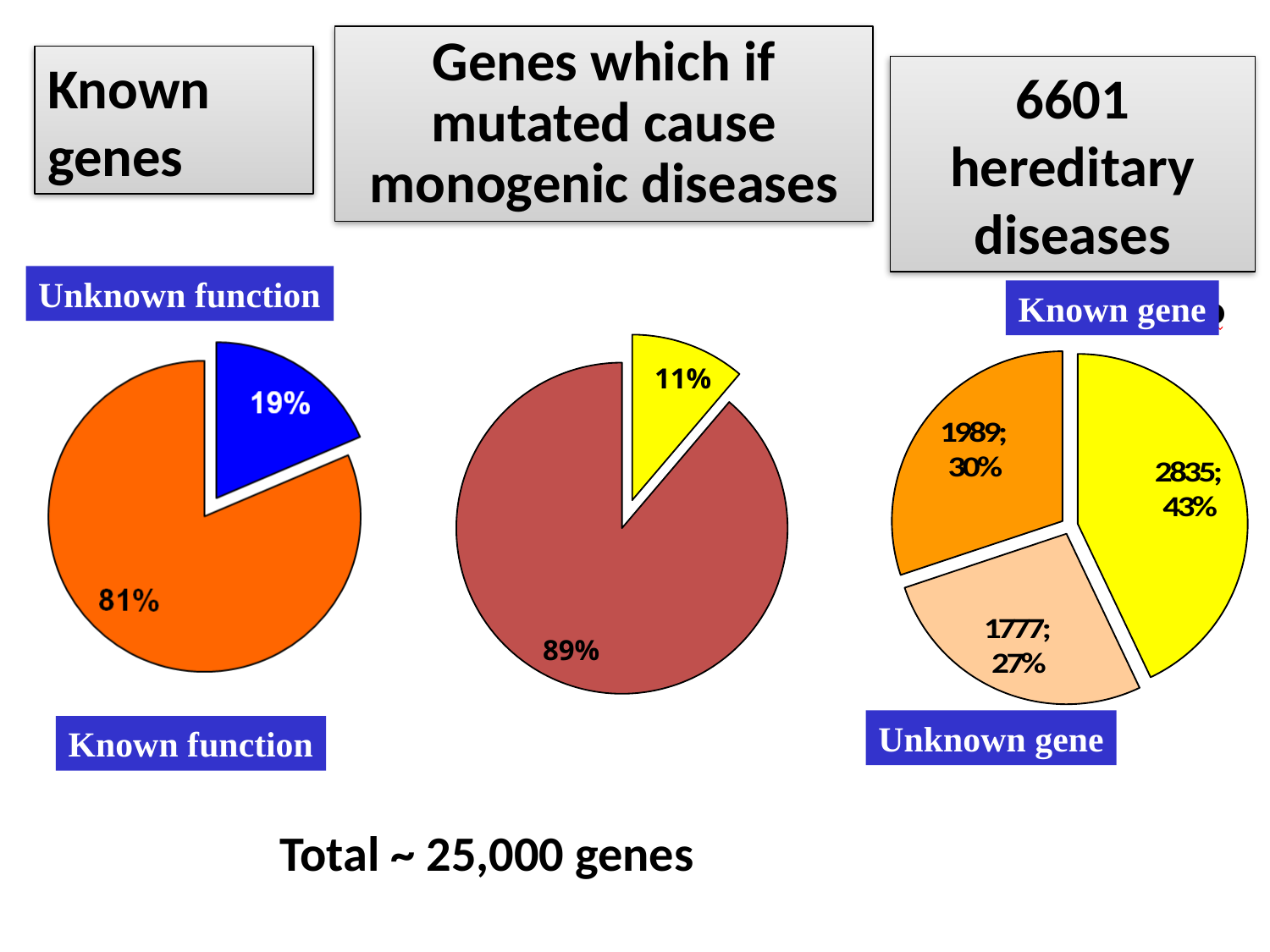
How many slices does the 'Known genes' pie chart on the left have? 2 In the '6601 hereditary diseases' pie chart on the right, what share does the 'Known gene' slice represent? 43% In the middle pie chart ('Genes which if mutated cause monogenic diseases'), what is the share of the smallest slice? 11% In the middle pie chart ('Genes which if mutated cause monogenic diseases'), what is the share of the largest slice? 89% In the 'Known genes' pie chart on the left, what share of genes has known function? 81% In the 'Known genes' pie chart on the left, which slice is larger, Known function or Unknown function? Known function How many slices does the '6601 hereditary diseases' pie chart on the right have? 3 In the '6601 hereditary diseases' pie chart on the right, what is the difference between the slice of 1989 and the slice of 1777? 212 How many slices does the middle pie chart ('Genes which if mutated cause monogenic diseases') have? 2 In the 'Known genes' pie chart on the left, what share of genes has unknown function? 19% What kind of chart is the 'Known genes' chart on the left? Pie chart In the '6601 hereditary diseases' pie chart on the right, how many diseases are in the 'Known gene' slice? 2835